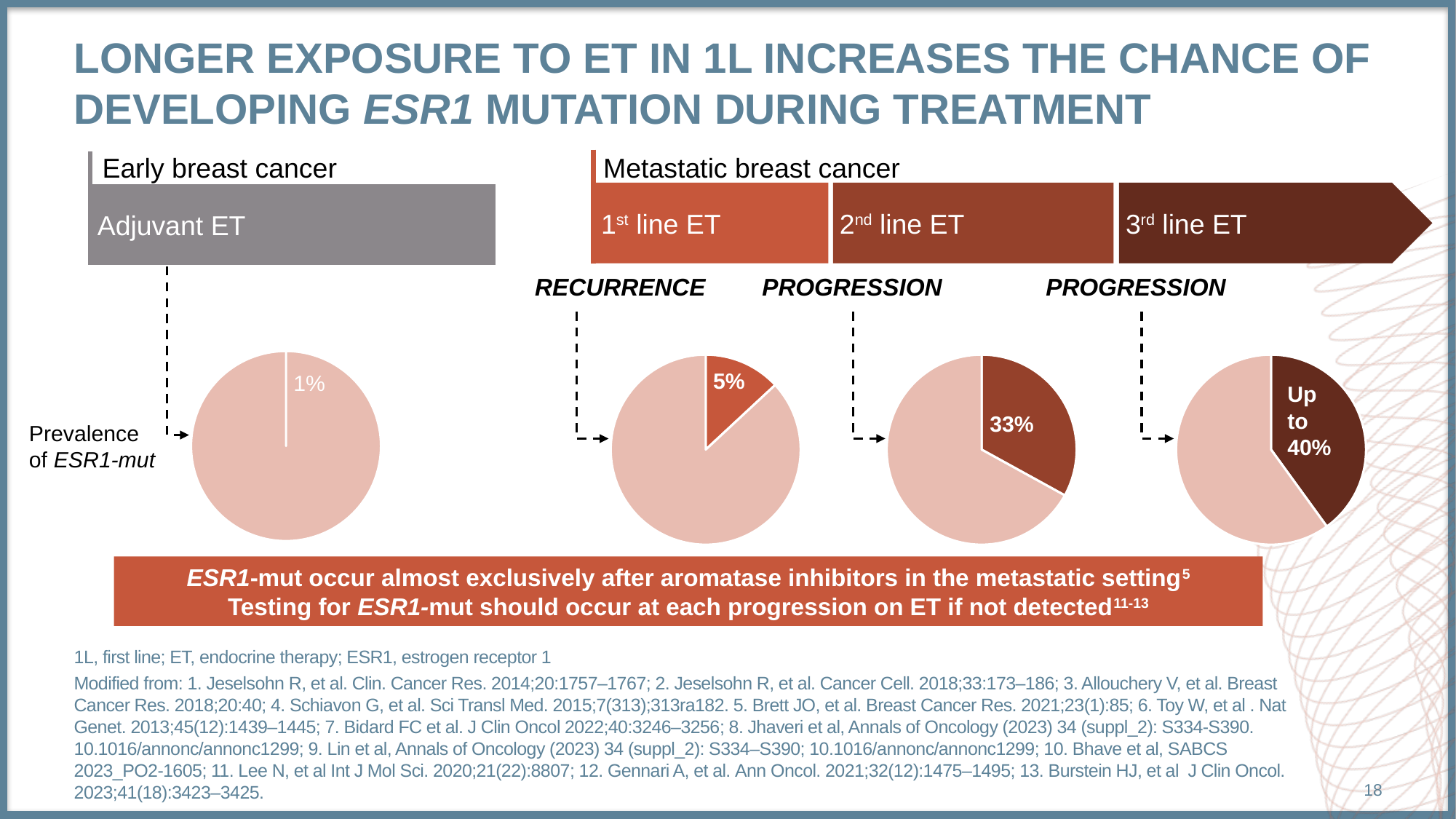
In the pie chart under 3rd line ET (after the second progression), what is the prevalence of ESR1-mut? Up to 40% Which pie chart shows the lowest prevalence of ESR1-mut? Adjuvant ET (early breast cancer) In the pie chart under Adjuvant ET (early breast cancer), what is the prevalence of ESR1-mut? 1% Which is larger: the ESR1-mut prevalence in the 1st line ET pie chart or in the 2nd line ET pie chart? 2nd line ET What kind of charts are used to show the prevalence of ESR1-mut on this slide? Pie charts In the pie chart under 2nd line ET (after the first progression), what is the prevalence of ESR1-mut? 33% Does the prevalence of ESR1-mut rise or fall moving from adjuvant ET through 1st, 2nd and 3rd line ET? Rise What label is written to the left of the first pie chart describing what the pie charts show? Prevalence of ESR1-mut How many pie charts are shown on the slide? 4 Which pie chart shows the highest prevalence of ESR1-mut? 3rd line ET In the pie chart under 1st line ET (after recurrence), what is the prevalence of ESR1-mut? 5% What is the difference in ESR1-mut prevalence between the 2nd line ET pie chart and the 1st line ET pie chart? 28%